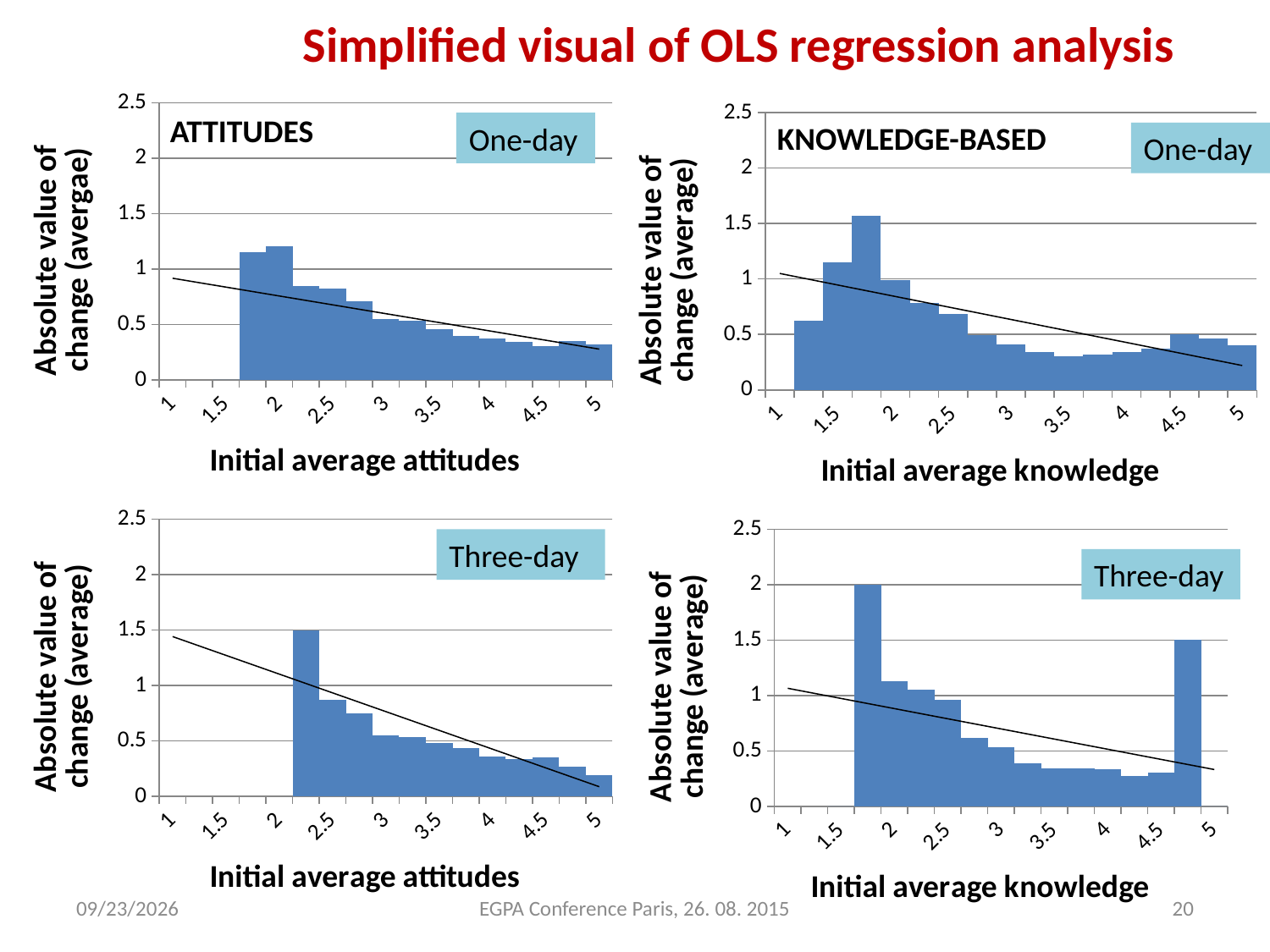
In the bottom-right Three-day knowledge chart, is the tallest bar greater or less than 1.5? greater In the top-right KNOWLEDGE-BASED One-day chart, is the leftmost bar greater or less than 1? less What is the x-axis title of the top-right KNOWLEDGE-BASED One-day chart? Initial average knowledge How many charts are shown on the slide? 4 In the bottom-right Three-day knowledge chart, is the rightmost bar (near 4.75) greater or less than 1? greater In the top-left ATTITUDES One-day chart, do the bar values generally rise or fall as initial average attitudes increase? fall What kind of chart is the top-left ATTITUDES One-day chart? bar chart In the bottom-right Three-day knowledge chart, does the fitted trend line rise or fall from left to right? fall In the bottom-left Three-day attitudes chart, does the fitted trend line rise or fall from left to right? fall